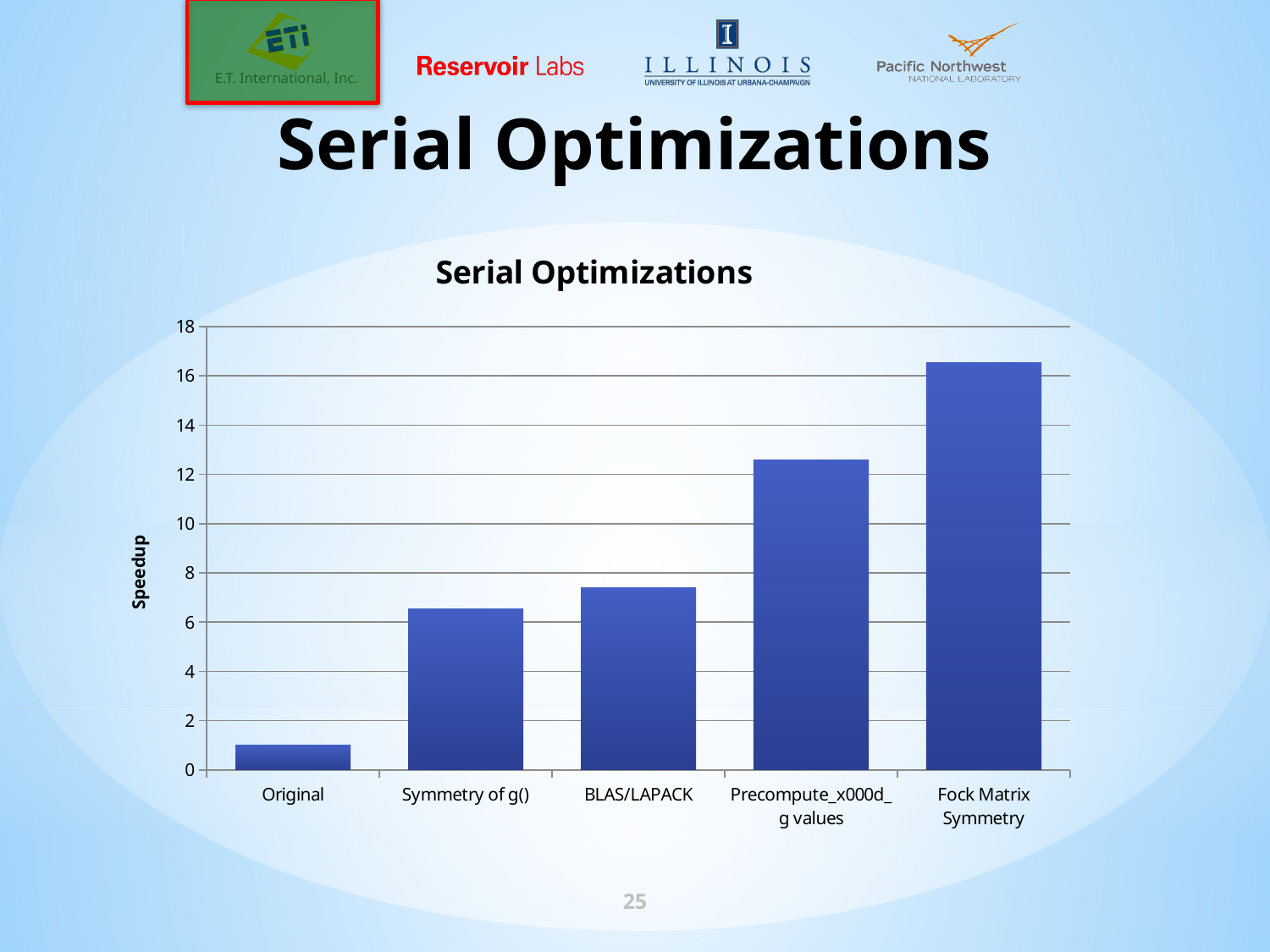
What type of chart is shown on the slide? bar chart Which has a larger speedup, BLAS/LAPACK or Precompute g values? Precompute g values What is the title of the chart? Serial Optimizations How many categories are shown on the x axis? 5 Is the speedup for BLAS/LAPACK greater or less than 6? greater Do the speedup values rise or fall from left to right along the x axis? rise Which category has the highest speedup? Fock Matrix Symmetry Is the speedup for Original greater or less than 2? less What is the label of the vertical axis? Speedup Is the speedup for Fock Matrix Symmetry greater or less than 16? greater Which category has the lowest speedup? Original